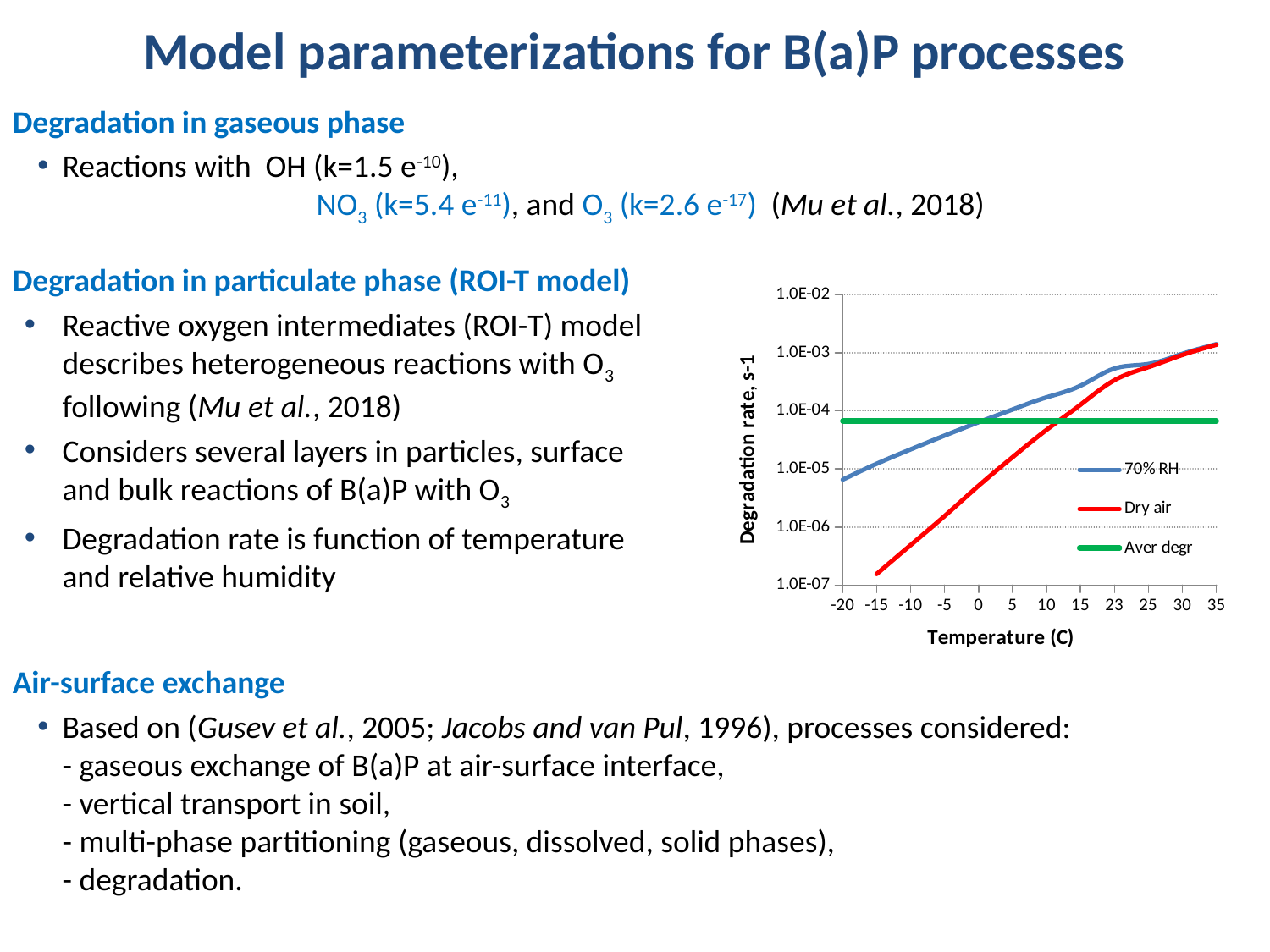
Is the Dry air value at -15 C greater or less than 1.0E-06? less How many temperature tick labels are shown on the x axis of the chart? 12 Is the 70% RH value at -20 C greater or less than 1.0E-05? less Does the Dry air degradation rate rise or fall as temperature increases? rise What is the label of the x axis of the chart? Temperature (C) Is the Aver degr value greater or less than 1.0E-04? less How many series does the chart legend list? 3 At -10 C, which series has the larger degradation rate, 70% RH or Dry air? 70% RH What are the three series named in the chart legend? 70% RH, Dry air, Aver degr What kind of chart is shown on the slide? line chart Does the 70% RH degradation rate rise or fall as temperature increases? rise